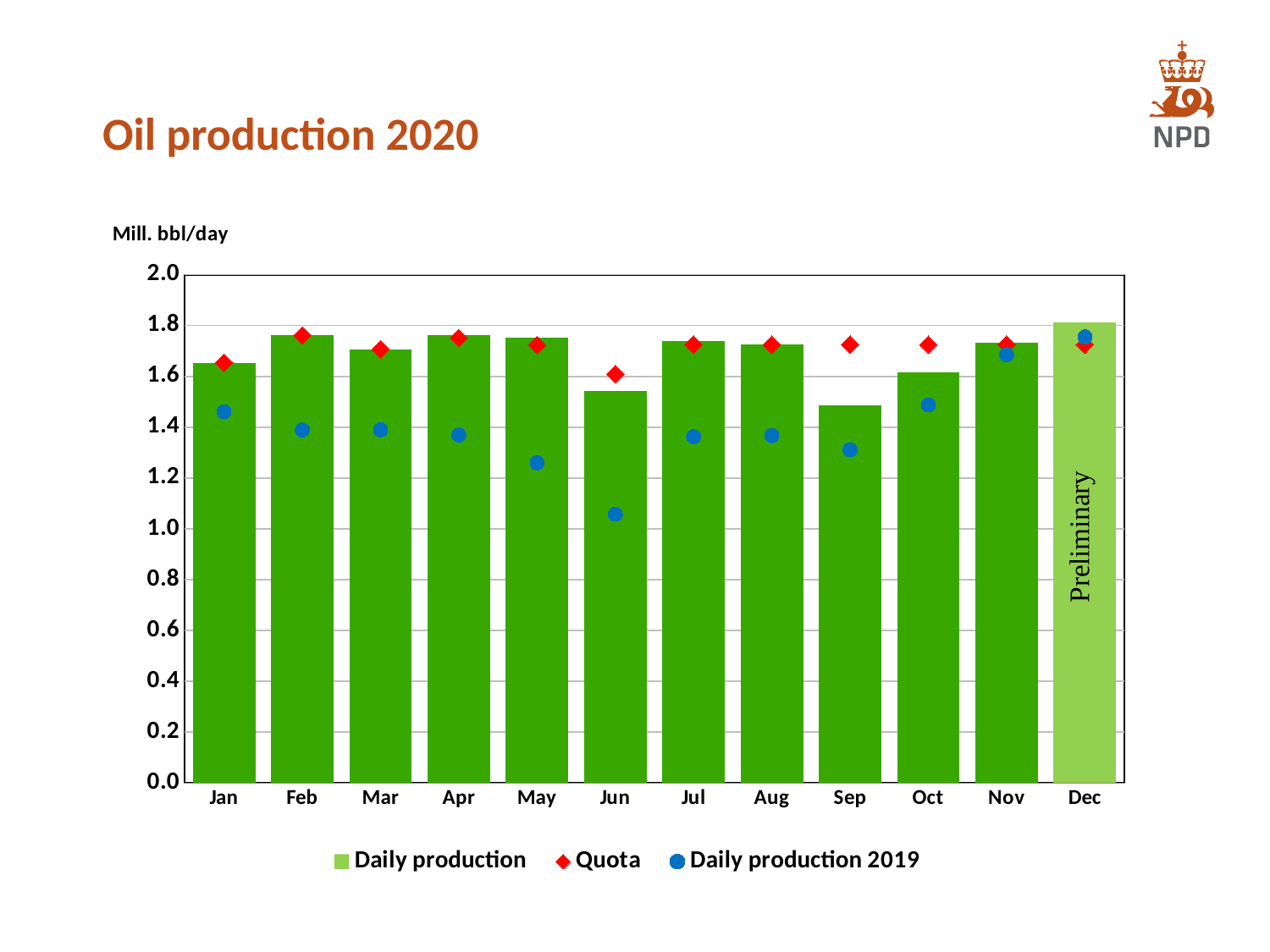
Is the Daily production 2019 value for Jun greater or less than 1.2? less Is the Daily production value for Sep greater or less than 1.6? less Which month has the highest Daily production bar? Dec What label is written on the Dec bar? Preliminary Which month has the lowest Daily production 2019 value? Jun How many series does the legend list? 3 Which month has the lowest Daily production bar? Sep Which month has the lowest Quota value? Jun Which is larger, the Daily production bar for Jun or for Sep? Jun What kind of chart is shown on the slide? Bar chart How many months are shown on the x axis of the chart? 12